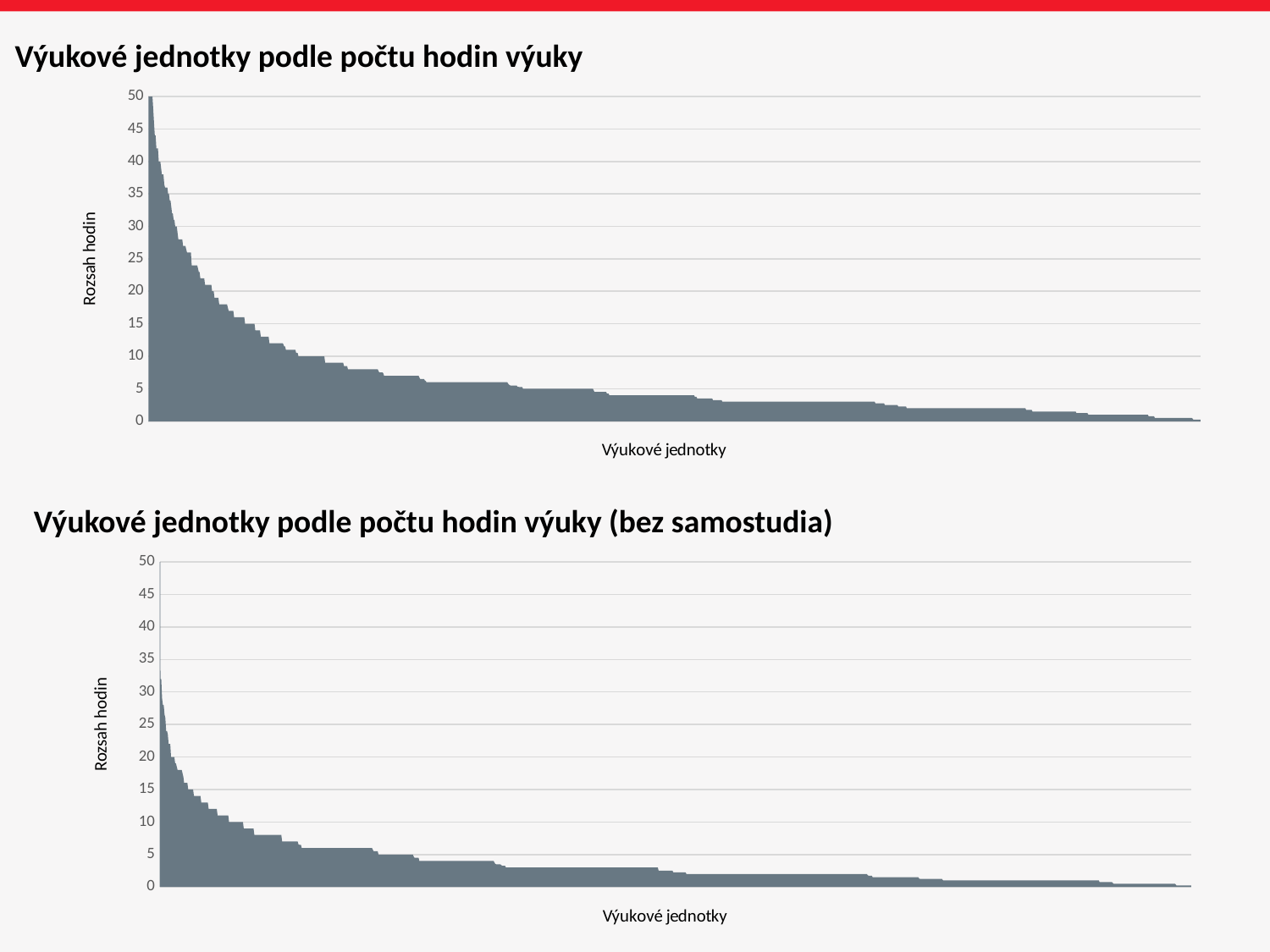
What is the title of the bottom chart? Výukové jednotky podle počtu hodin výuky (bez samostudia) What is the label of the vertical axis in the top chart? Rozsah hodin Which chart has the larger maximum value: the top chart or the bottom chart (bez samostudia)? the top chart In the bottom chart (bez samostudia), is the value of the right-most teaching unit greater or less than 5? less In the top chart, is the value of the left-most (highest) teaching unit greater or less than 45? greater In the top chart, is the value of the right-most teaching unit greater or less than 5? less In the top chart, do the values rise or fall moving from left to right along the x axis? fall In the bottom chart (bez samostudia), do the values rise or fall moving from left to right along the x axis? fall